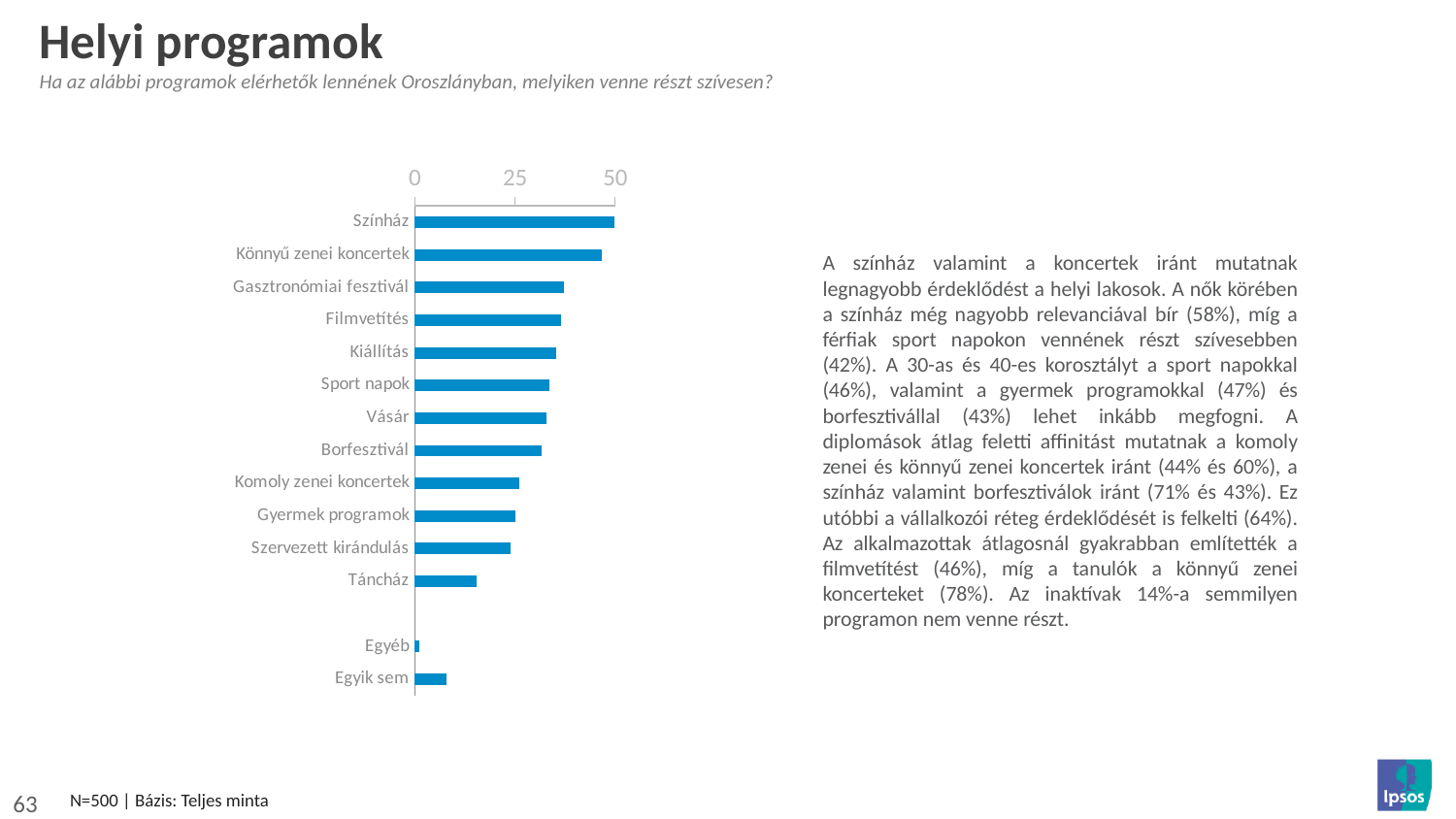
Which has a larger value, Egyik sem or Egyéb? Egyik sem Is the value for Borfesztivál greater or less than 25? greater Is the value for Táncház greater or less than 25? less Which has a larger value, Gasztronómiai fesztivál or Borfesztivál? Gasztronómiai fesztivál Is the value for Könnyű zenei koncertek greater or less than 50? less How many categories are plotted in the chart? 14 Which category has the longest bar in the chart? Színház What is the title of the slide containing the chart? Helyi programok Which category has the shortest bar in the chart? Egyéb What kind of chart is shown on the slide? bar chart